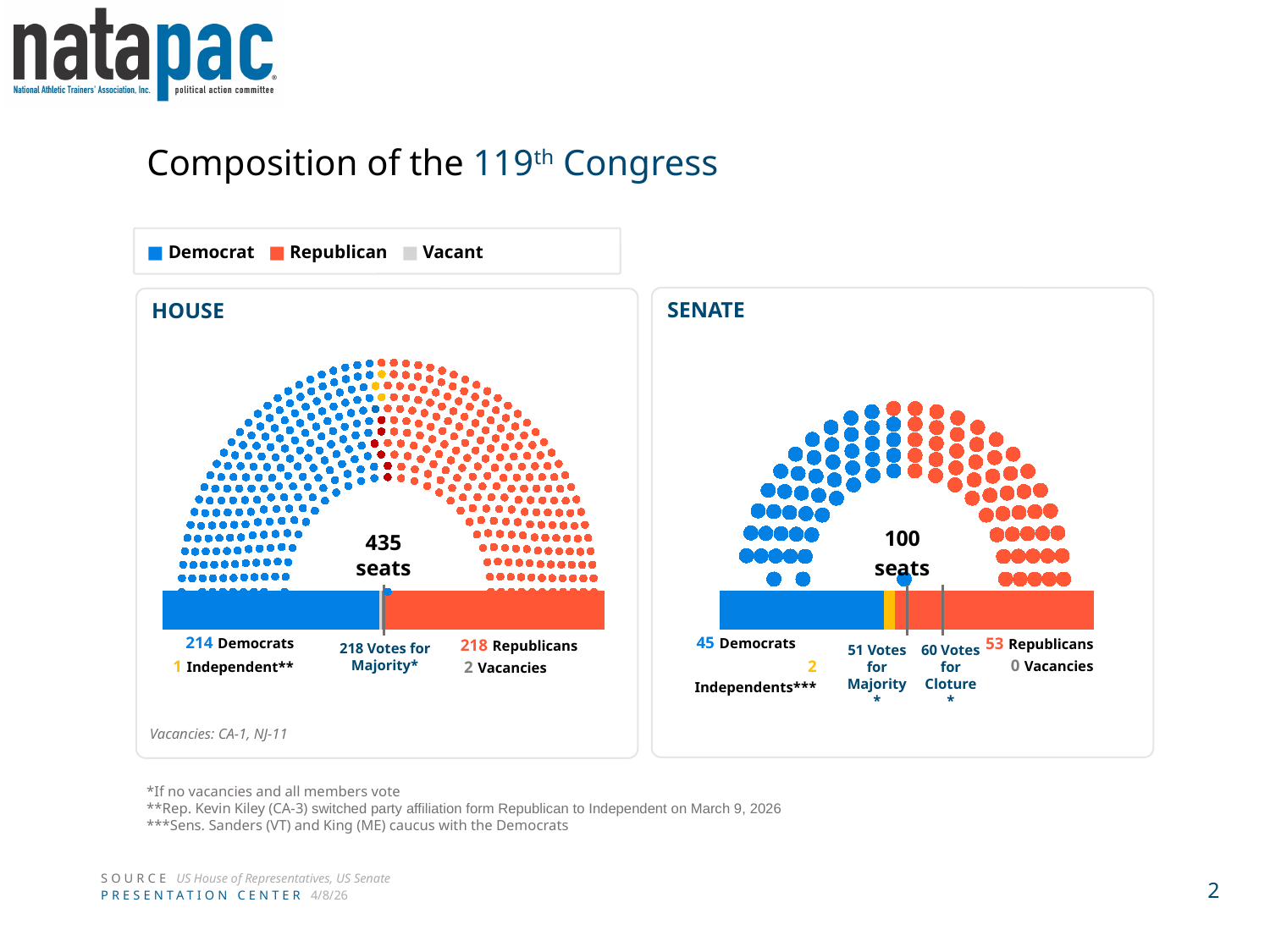
On the HOUSE chart, how many Democrats are shown? 214 On the HOUSE chart, how many more Republicans than Democrats are there? 4 On the SENATE chart, how many Democrats are shown? 45 On the HOUSE chart, how many Republicans are shown? 218 On the HOUSE chart, how many vacancies are shown? 2 On the SENATE chart, what is the difference between the number of Republicans and the number of Democrats? 8 On the HOUSE chart, which party has more members, Democrats or Republicans? Republicans How many entries does the legend above the charts list? 3 On the SENATE chart, how many votes are needed for cloture? 60 On the HOUSE chart, how many total seats are indicated? 435 seats On the SENATE chart, how many Republicans are shown? 53 On the SENATE chart, how many Independents are shown? 2